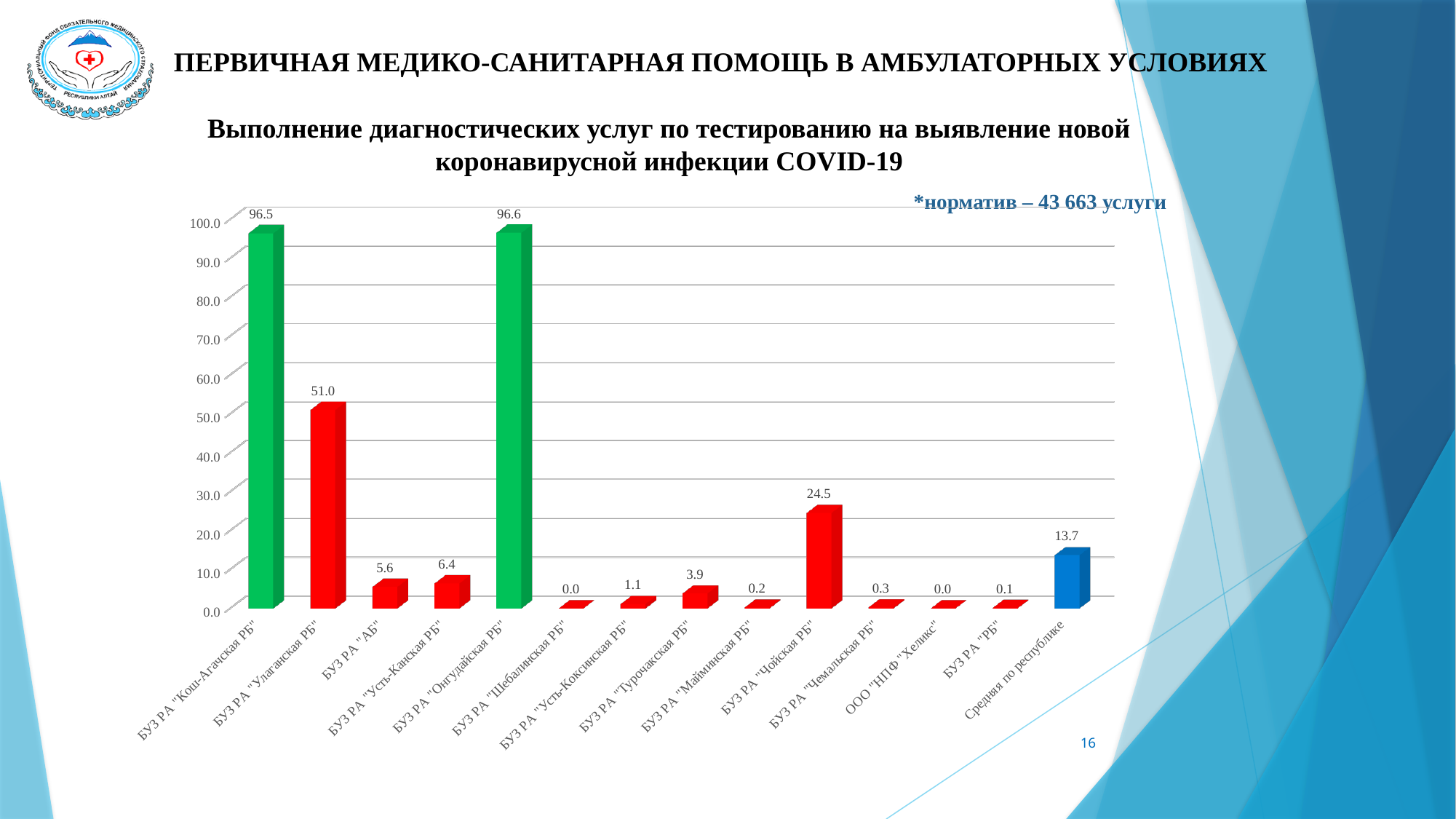
Is the value for БУЗ РА "Улаганская РБ" greater or less than 40.0? greater What is the difference between the values for БУЗ РА "Улаганская РБ" and БУЗ РА "Чойская РБ"? 26.5 What is the value for Средняя по республике? 13.7 How many categories are shown on the x axis of the chart? 14 What colour is the bar for Средняя по республике? blue What is the value for БУЗ РА "Улаганская РБ"? 51.0 What is the difference between the values for БУЗ РА "Усть-Канская РБ" and БУЗ РА "АБ"? 0.8 What is the value for БУЗ РА "Чойская РБ"? 24.5 What is the value for БУЗ РА "Усть-Канская РБ"? 6.4 Which is larger, the value for БУЗ РА "Чойская РБ" or the value for Средняя по республике? БУЗ РА "Чойская РБ" What is the value for БУЗ РА "Турочакская РБ"? 3.9 What kind of chart is shown on the slide? bar chart